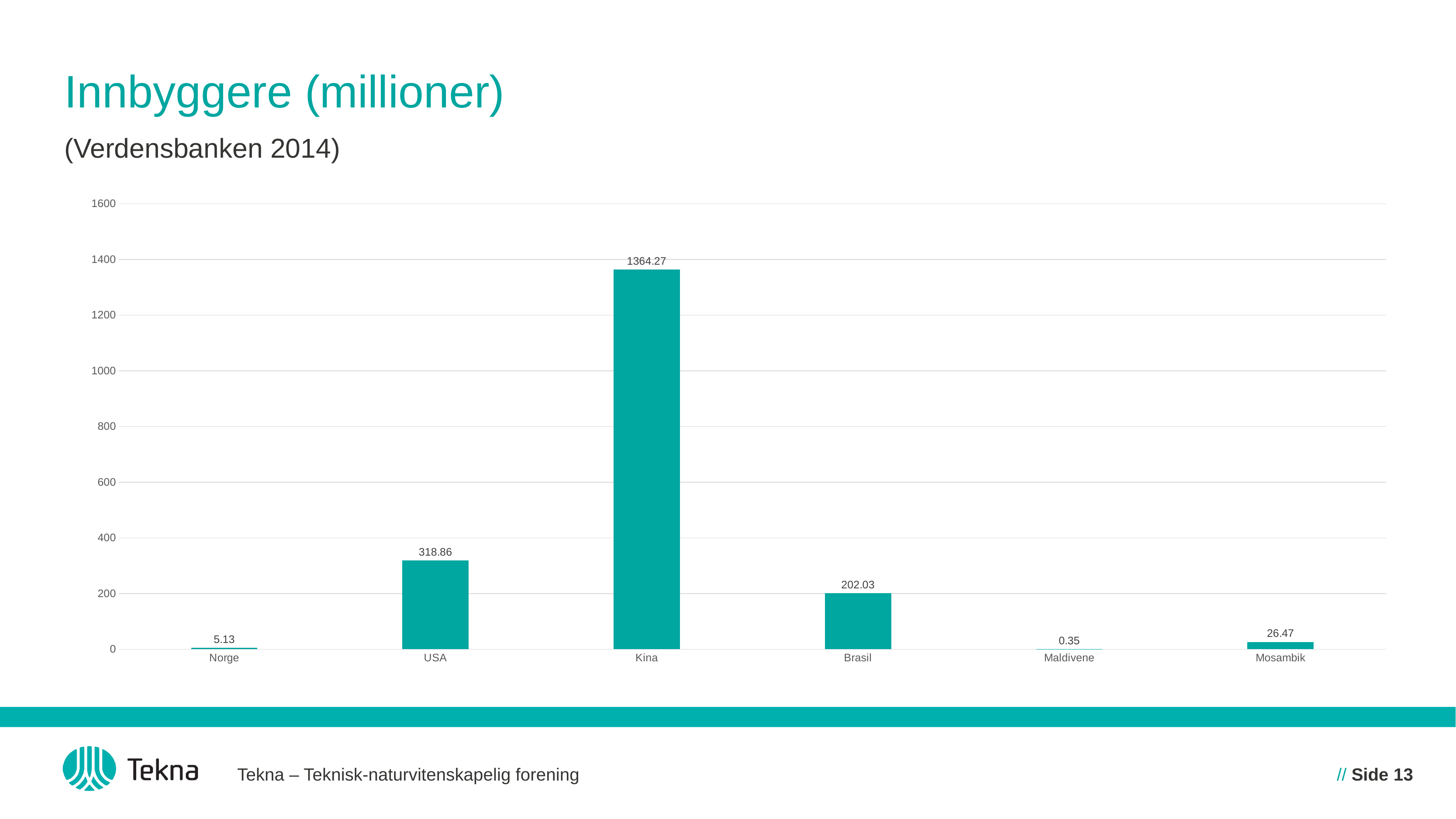
Which category has the lowest value? Maldivene What kind of chart is shown on the slide? bar chart Which is larger, the value for Norge or the value for Mosambik? Mosambik What is the difference between the values for USA and Brasil? 116.83 What is the value for USA? 318.86 How many categories are shown on the x axis? 6 Is the value for Brasil greater or less than 400? less What is the value for Mosambik? 26.47 Which category has the highest value? Kina What is the value for Maldivene? 0.35 What is the title of the slide? Innbyggere (millioner) What is the value for Kina? 1364.27